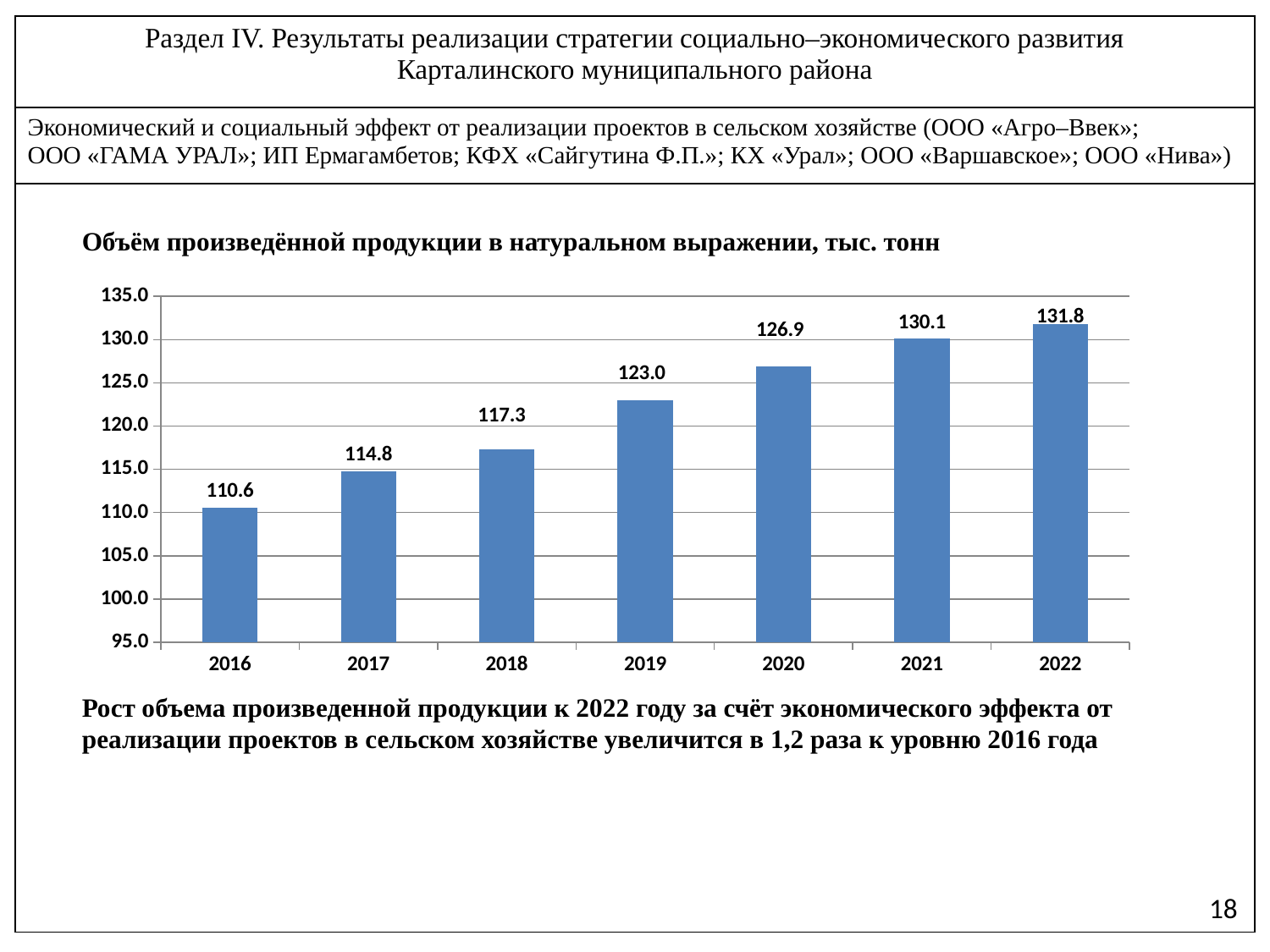
Which year has the highest value? 2022 Is the value for 2017 greater or less than 120.0? less What is the difference between the values for 2022 and 2016? 21.2 Which year has the lowest value? 2016 Which is larger, the value for 2018 or the value for 2021? 2021 How many years are shown on the x axis? 7 What kind of chart is shown? bar chart What is the value for 2019? 123.0 Do the values rise or fall from 2016 to 2022? rise What is the value for 2022? 131.8 What is the value for 2016? 110.6 What is the difference between the values for 2020 and 2019? 3.9